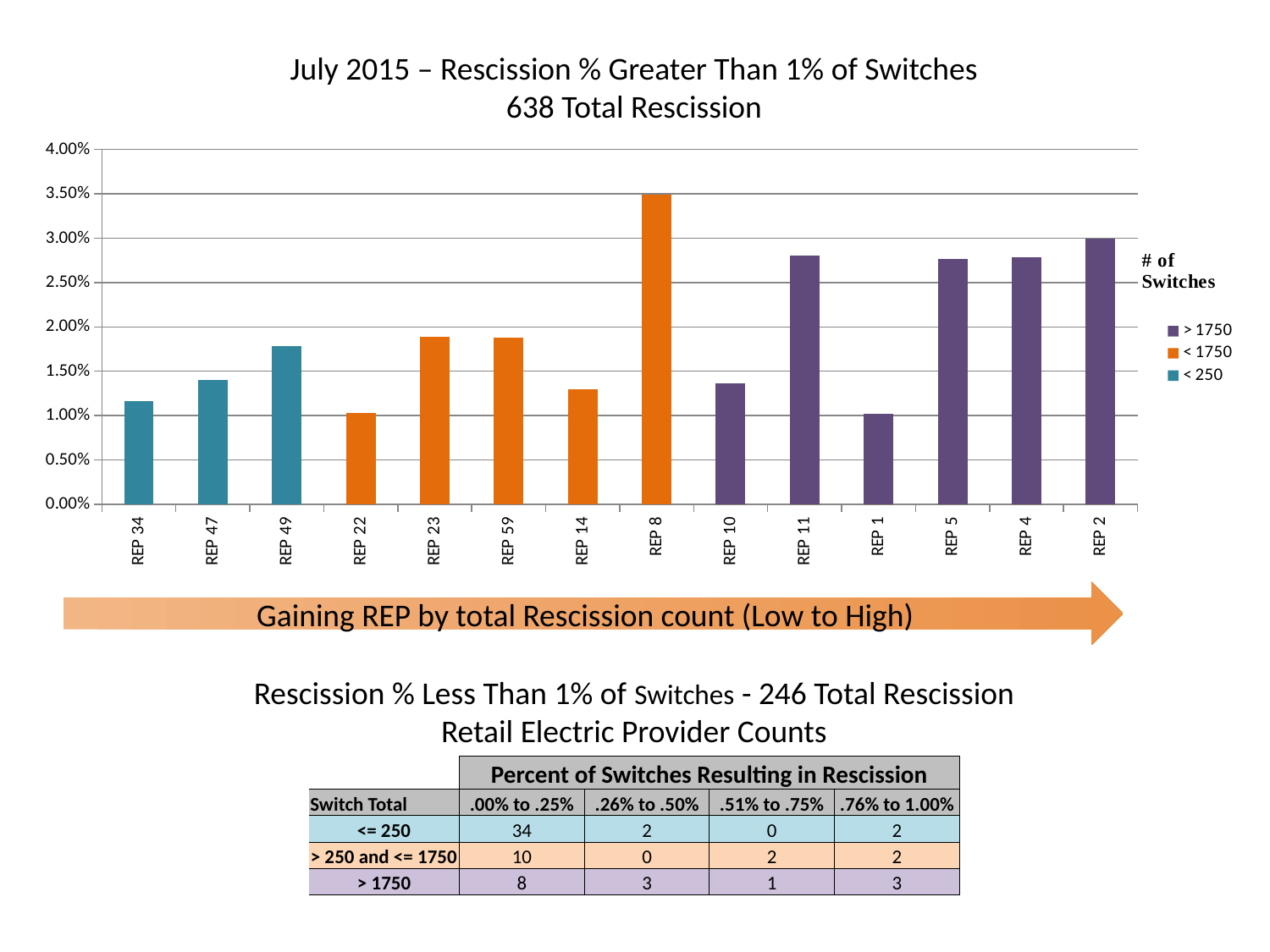
What kind of chart is shown on the slide? bar chart What is the title of the chart's legend? # of Switches Is the value for REP 8 greater or less than 3.00%? greater Which REP has the highest rescission percentage in the chart? REP 8 Which has the larger rescission percentage, REP 8 or REP 2? REP 8 How many series does the chart's legend list? 3 How many REPs are plotted on the x axis of the chart? 14 Is the value for REP 2 greater or less than 2.50%? greater Is the value for REP 22 greater or less than 1.50%? less Which legend series is shown in orange? < 1750 Which has the larger rescission percentage, REP 11 or REP 10? REP 11